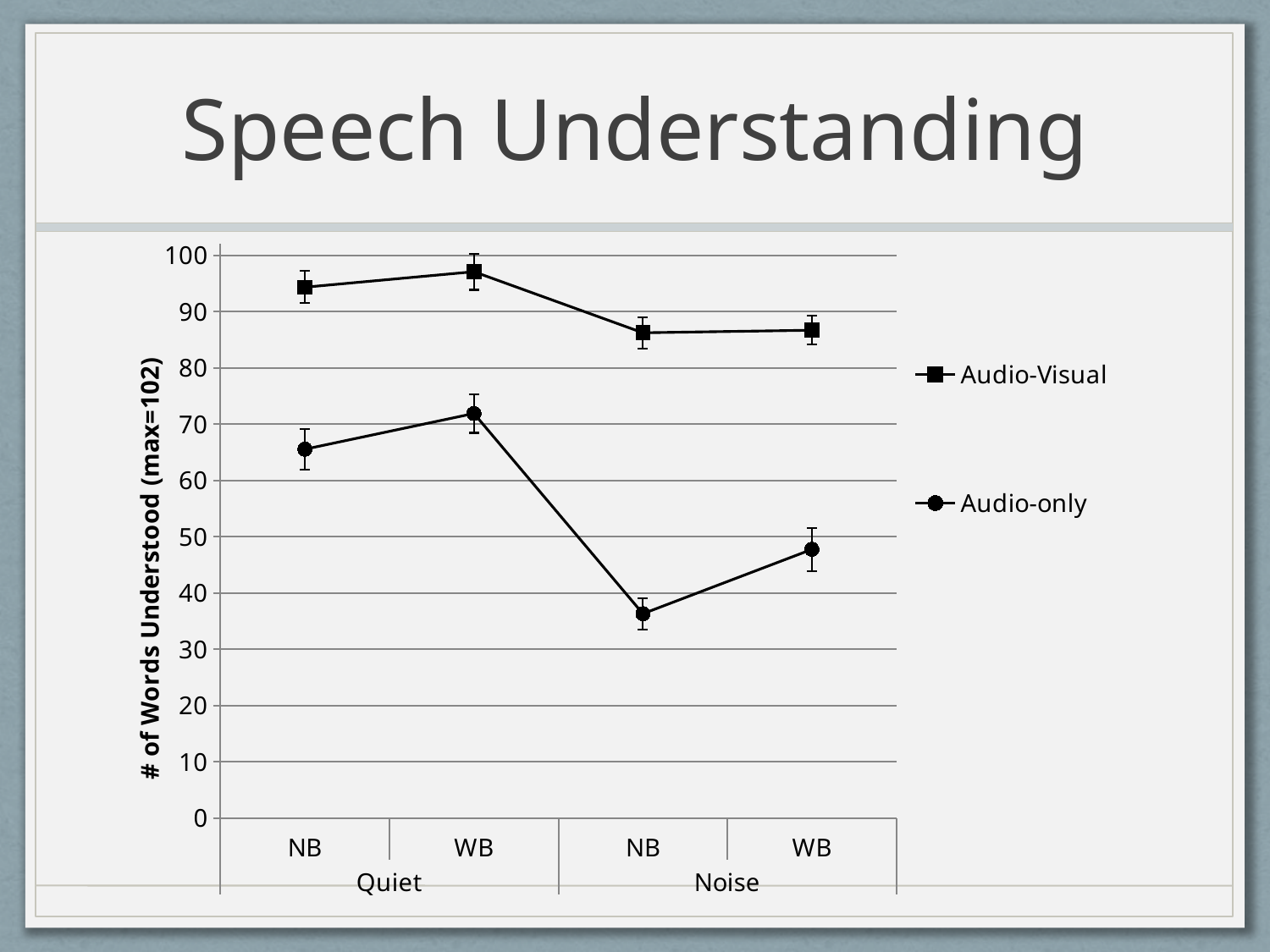
Does the Audio-only series rise or fall from WB in Quiet to NB in Noise? fall How many data points does the Audio-only series have? 4 At which condition is the Audio-only series lowest? NB in Noise For NB in Noise, which series has the larger value, Audio-Visual or Audio-only? Audio-Visual What is the title of the vertical axis? # of Words Understood (max=102) Is the Audio-Visual value for NB in Noise greater or less than 90? less How many series does the legend list? 2 Is the Audio-only value for NB in Quiet greater or less than 60? greater What kind of chart is shown on the slide? line chart Is the Audio-Visual value for WB in Quiet greater or less than 90? greater At which condition is the Audio-only series highest? WB in Quiet